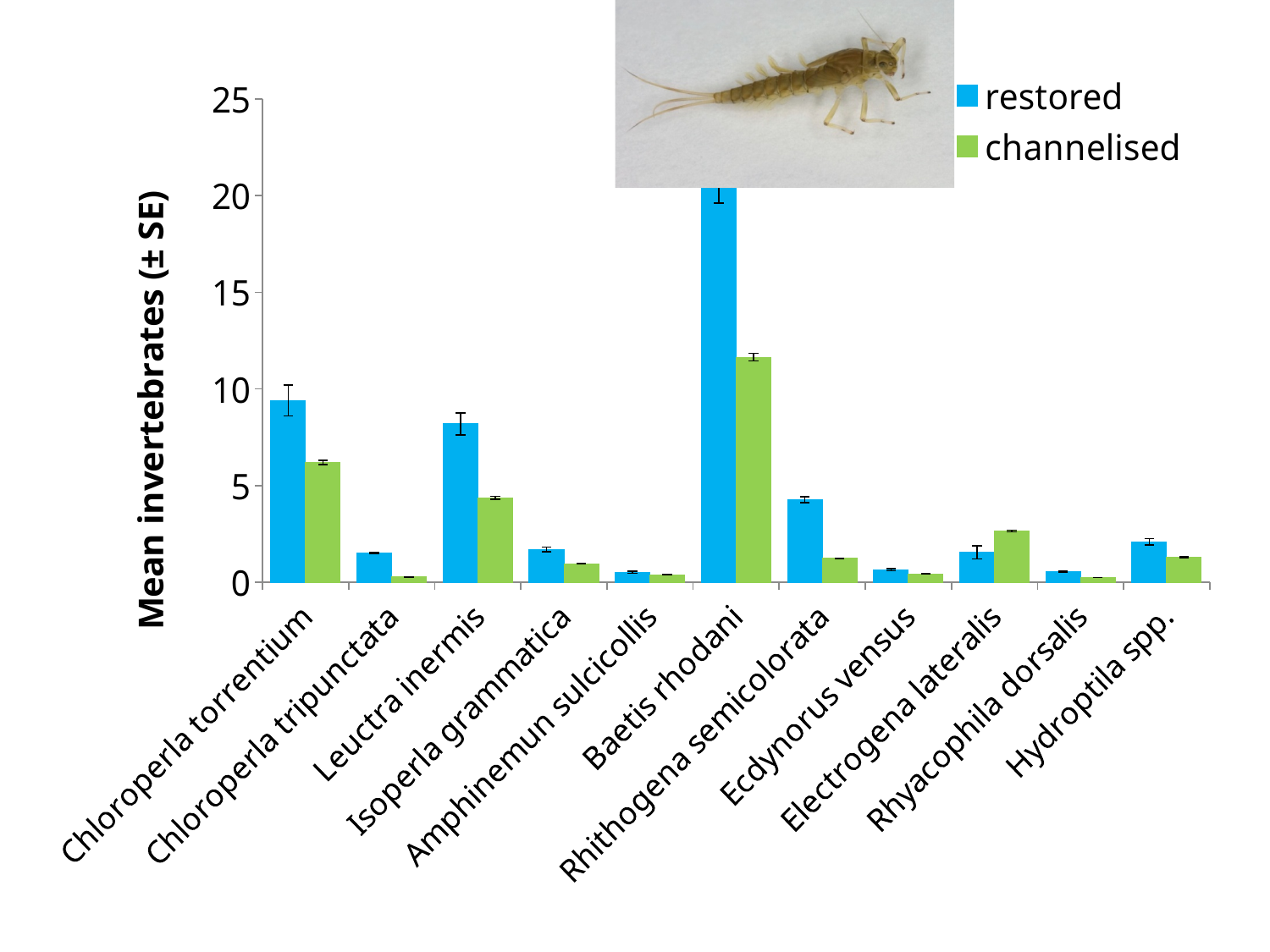
Which species has the highest restored value? Baetis rhodani How many species categories are shown on the x axis? 11 Which species has the highest channelised value? Baetis rhodani Is the channelised value for Baetis rhodani greater or less than 10? greater Is the restored value for Leuctra inermis greater or less than 5? greater Is the channelised value for Electrogena lateralis greater or less than 5? less How many series does the legend list? 2 For Electrogena lateralis, which is larger: the restored or the channelised value? channelised What kind of chart is shown on the slide? bar chart What is the label on the y axis? Mean invertebrates (± SE) For Chloroperla torrentium, which is larger: the restored or the channelised value? restored